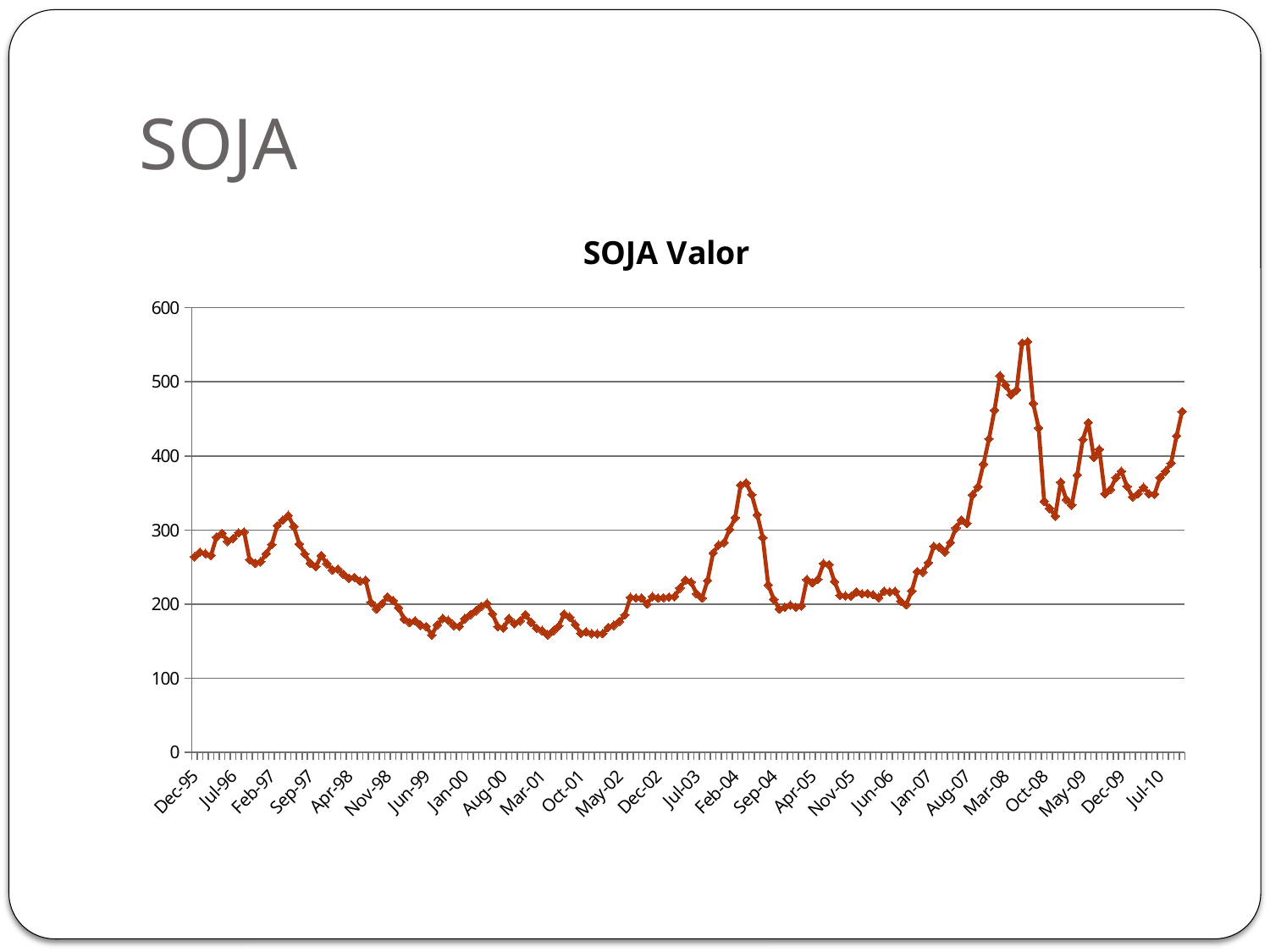
What is the title of the chart? SOJA Valor Is the value for Jun-99 greater or less than 200? less Is the value for Dec-95 greater or less than 300? less Does the value rise or fall between Jan-07 and Mar-08? rise What kind of chart is shown on the slide? line chart Is the value for Feb-04 greater or less than 300? greater Which has the larger value, Feb-04 or Jun-99? Feb-04 How many lines (series) are plotted on the chart? 1 Does the value rise or fall between Dec-95 and Jun-99? fall